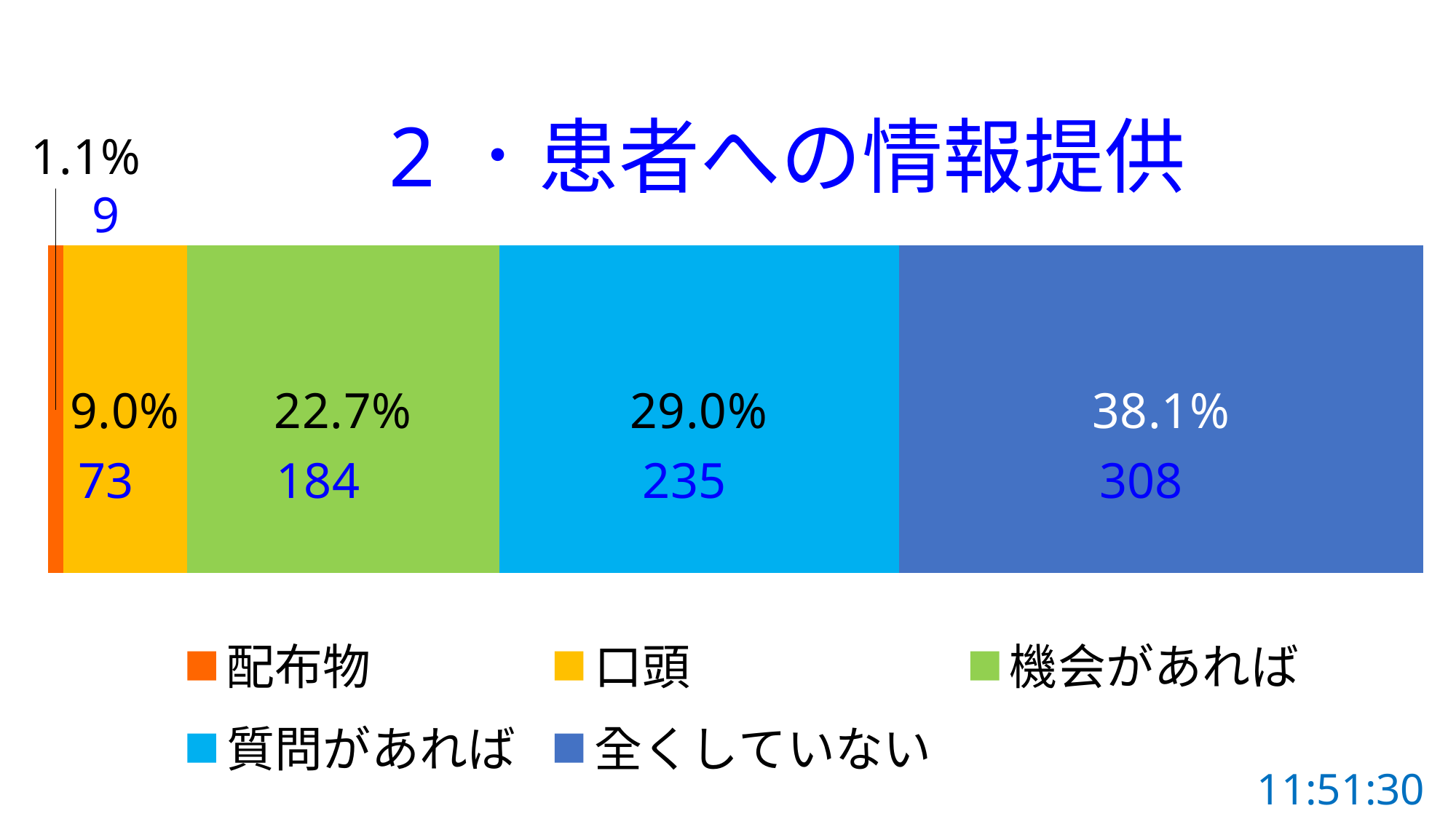
Which is larger, the count for 口頭 or the count for 機会があれば? 機会があれば What count is shown for 質問があれば? 235 What percentage is shown for 機会があれば? 22.7% What is the total count across all segments of the bar? 809 What percentage is shown for 全くしていない? 38.1% Which category has the largest share? 全くしていない What kind of chart is shown on the slide? Stacked bar chart Which category has the smallest share? 配布物 How many categories does the legend list? 5 What count is shown for 配布物? 9 What is the difference in count between 全くしていない and 質問があれば? 73 What is the title of the chart? 2・患者への情報提供